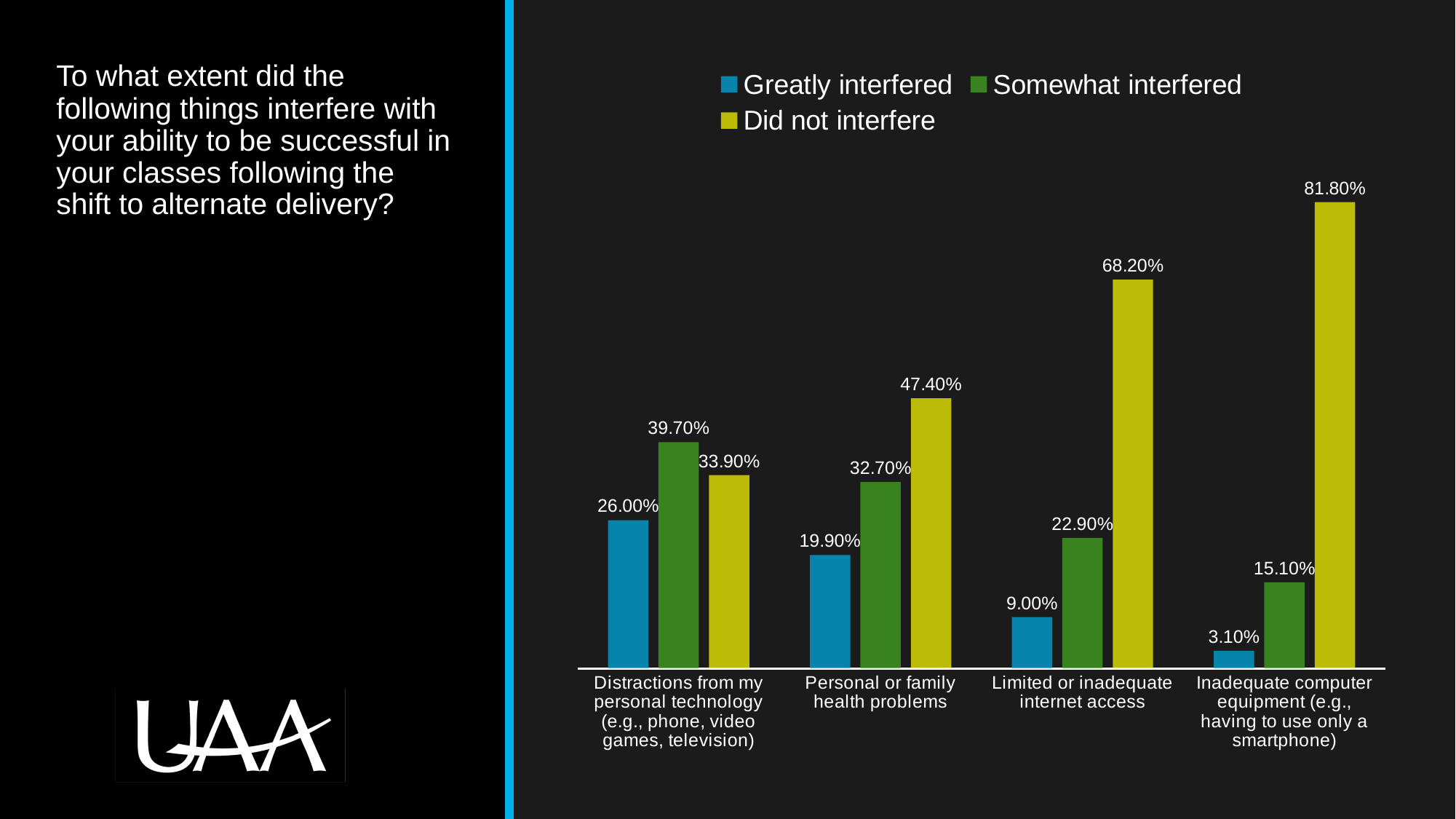
What kind of chart is shown on the slide? Bar chart Which colour represents the 'Greatly interfered' series? Blue How many categories are shown on the x axis? 4 How many series does the legend list? 3 What is the 'Somewhat interfered' value for Limited or inadequate internet access? 22.90% What is the 'Did not interfere' value for Inadequate computer equipment? 81.80% What is the difference between the 'Did not interfere' and 'Greatly interfered' values for Personal or family health problems? 27.50% For Limited or inadequate internet access, which is larger: 'Greatly interfered' or 'Somewhat interfered'? Somewhat interfered Do the 'Did not interfere' values rise or fall from left to right across the categories? Rise What is the 'Greatly interfered' value for Distractions from my personal technology? 26.00% Which category has the lowest 'Did not interfere' value? Distractions from my personal technology Which category has the highest 'Greatly interfered' value? Distractions from my personal technology